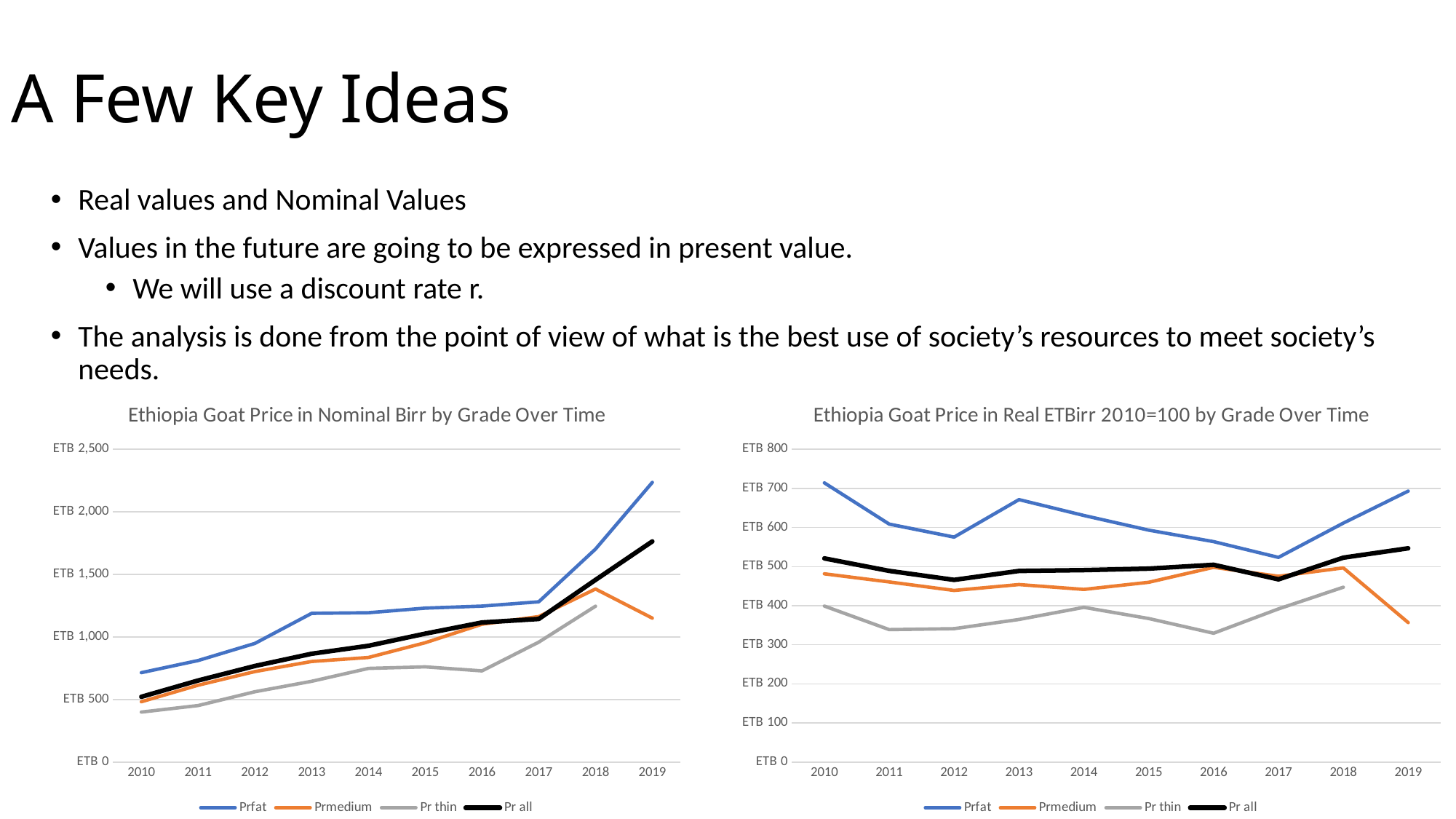
In the right chart, 'Ethiopia Goat Price in Real ETBirr 2010=100 by Grade Over Time', which is larger in 2019: Prfat or Prmedium? Prfat In the right chart, 'Ethiopia Goat Price in Real ETBirr 2010=100 by Grade Over Time', is the Prfat value for 2010 greater or less than ETB 700? greater In the left chart, 'Ethiopia Goat Price in Nominal Birr by Grade Over Time', does the Prfat series generally rise or fall from 2010 to 2019? rise What colour is the Pr all series drawn in on the left chart, 'Ethiopia Goat Price in Nominal Birr by Grade Over Time'? black How many years are shown on the x axis of the left chart, 'Ethiopia Goat Price in Nominal Birr by Grade Over Time'? 10 What kind of chart is the left chart, 'Ethiopia Goat Price in Nominal Birr by Grade Over Time'? line chart How many series does the legend of the right chart, 'Ethiopia Goat Price in Real ETBirr 2010=100 by Grade Over Time', list? 4 In the right chart, 'Ethiopia Goat Price in Real ETBirr 2010=100 by Grade Over Time', is the Pr thin value for 2016 greater or less than ETB 400? less In the right chart, 'Ethiopia Goat Price in Real ETBirr 2010=100 by Grade Over Time', which series has the lowest value in 2010? Pr thin In the left chart, 'Ethiopia Goat Price in Nominal Birr by Grade Over Time', is the Pr thin value for 2010 greater or less than ETB 500? less In the left chart, 'Ethiopia Goat Price in Nominal Birr by Grade Over Time', which series has the highest value in 2019? Prfat